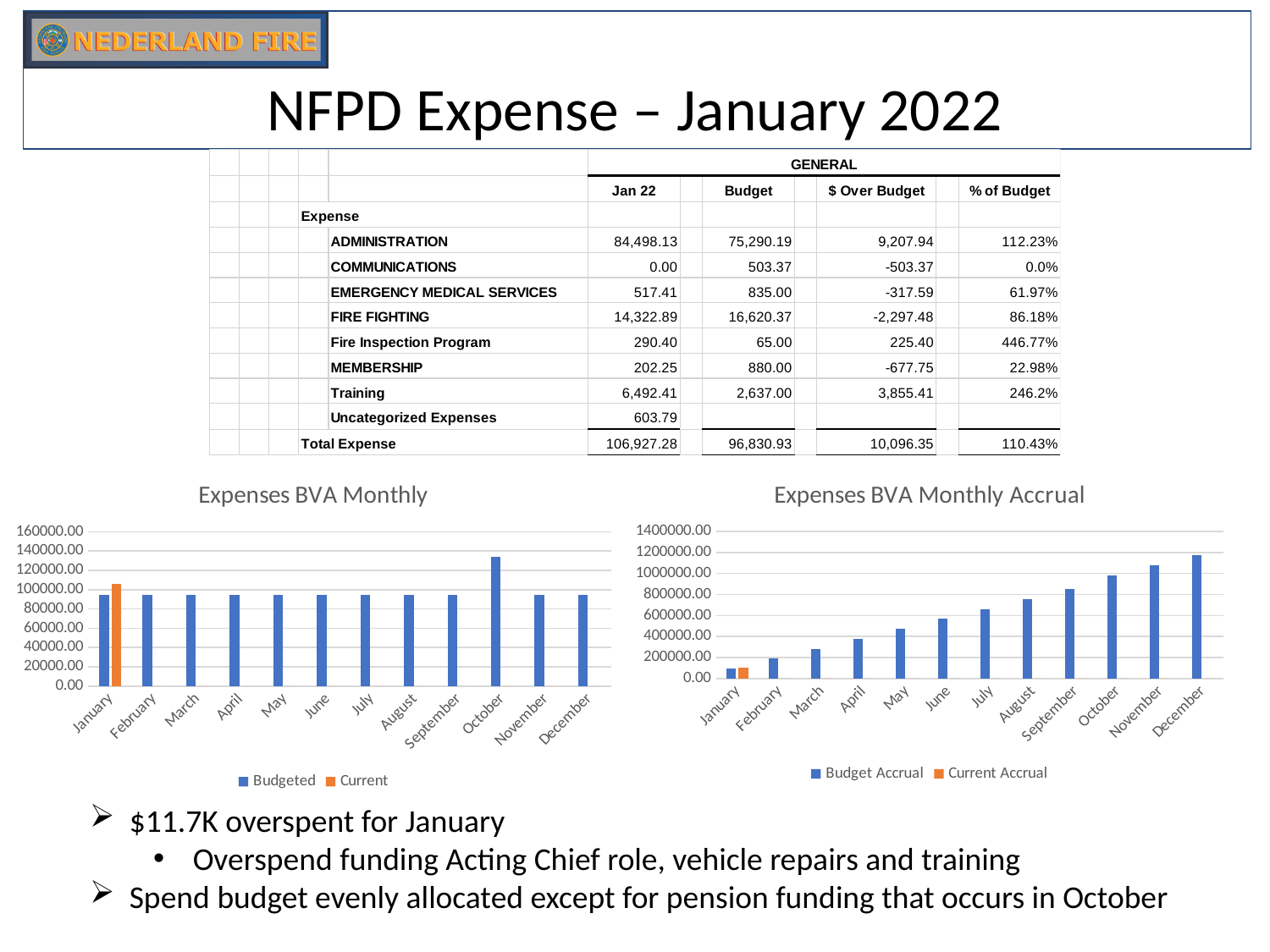
In the 'Expenses BVA Monthly Accrual' chart, which month has the highest Budget Accrual value? December In the 'Expenses BVA Monthly Accrual' chart, is the Budget Accrual value for March greater or less than 400000.00? less In the 'Expenses BVA Monthly Accrual' chart, do the Budget Accrual values rise or fall from January to December? Rise In the 'Expenses BVA Monthly' chart, how many series does the legend list? 2 In the 'Expenses BVA Monthly Accrual' chart, is the Budget Accrual value for December greater or less than 1000000.00? greater In the 'Expenses BVA Monthly' chart, is the Budgeted value for October greater or less than 120000.00? greater In the 'Expenses BVA Monthly' chart, which is larger for January: the Budgeted value or the Current value? Current In the 'Expenses BVA Monthly' chart, which month has the highest Budgeted value? October In the 'Expenses BVA Monthly' chart, what are the two legend entries? Budgeted and Current What kind of chart is the 'Expenses BVA Monthly' chart on the left? Bar chart In the 'Expenses BVA Monthly' chart, how many months are shown on the x axis? 12 In the 'Expenses BVA Monthly Accrual' chart, which month has the lowest Budget Accrual value? January